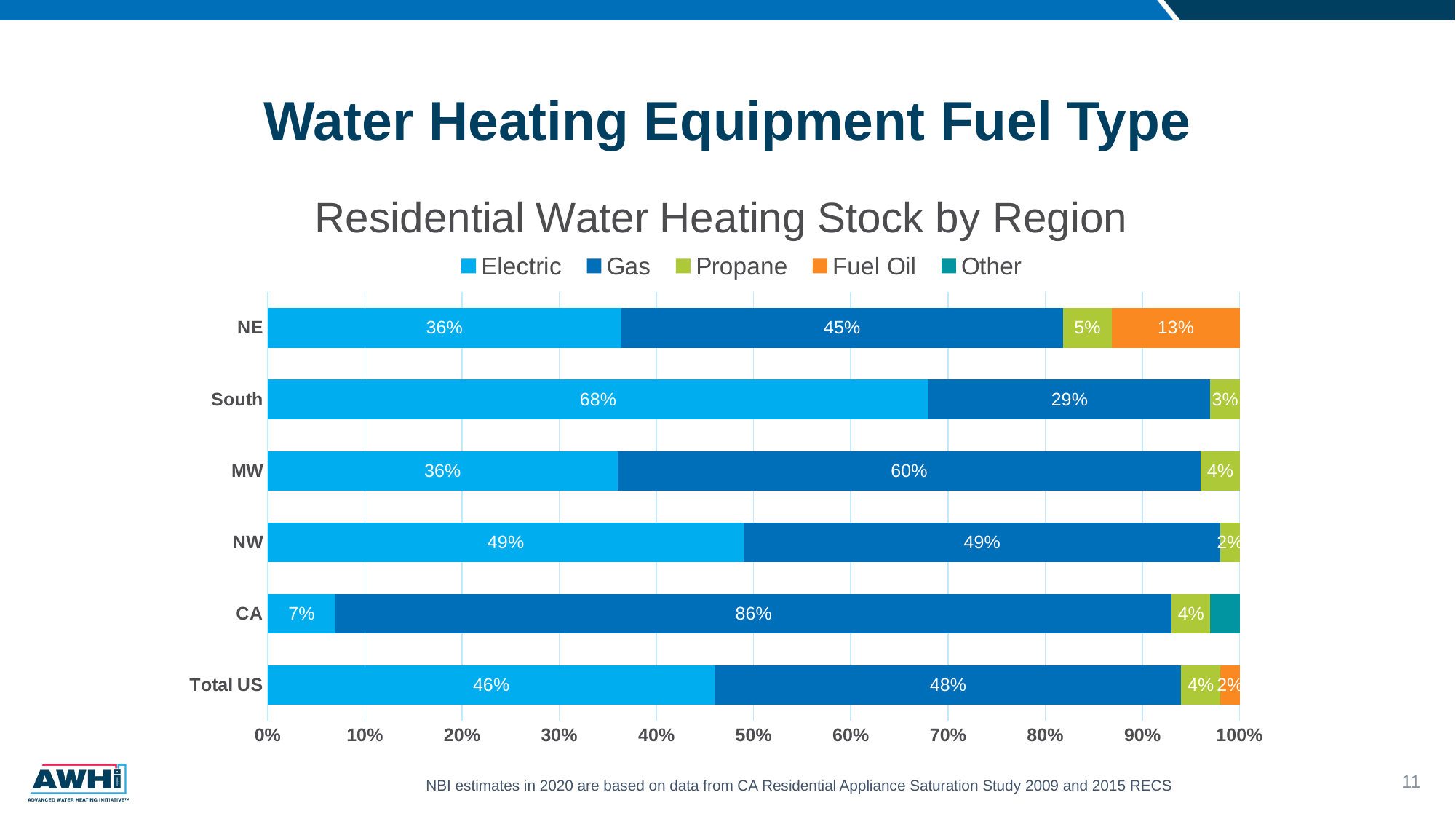
How many regions (categories) are shown on the chart? 6 What is the Fuel Oil share for NE? 13% What is the title of the chart? Residential Water Heating Stock by Region Which region has the lowest Electric share? CA What is the difference between the Gas share and the Electric share for NE? 9 percentage points Which is larger for MW, the Electric share or the Gas share? Gas Which region has the highest Gas share? CA What kind of chart is shown on the slide? Stacked bar chart How many series does the legend list? 5 What is the Propane share for Total US? 4% What is the Electric share for the South region? 68% What is the Gas share for CA? 86%